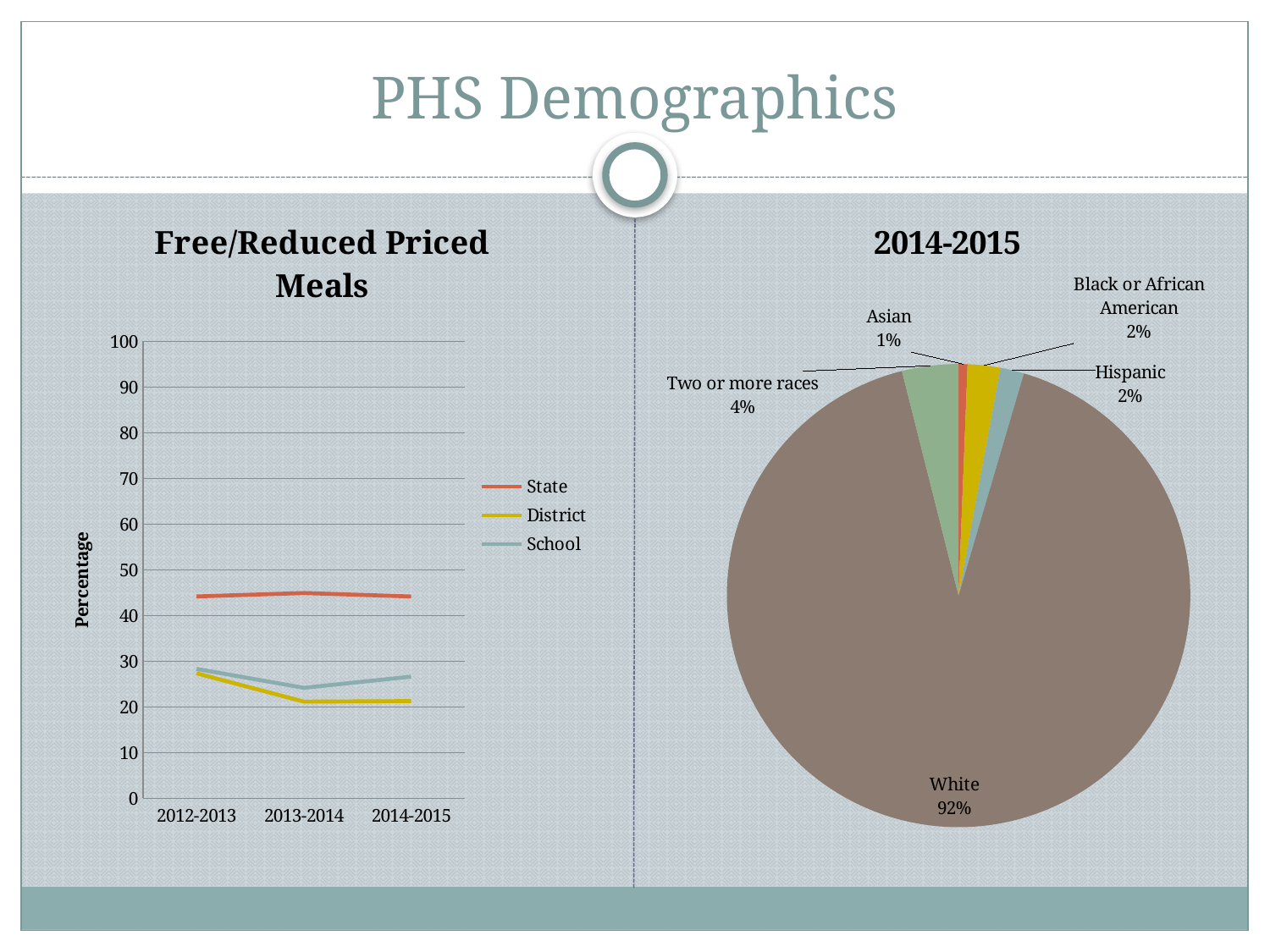
In the 'Free/Reduced Priced Meals' chart, is the District value for 2013-2014 greater or less than 30? less In the '2014-2015' pie chart, what share is Two or more races? 4% In the '2014-2015' pie chart, which category has the smallest share? Asian In the 'Free/Reduced Priced Meals' chart, how many school years are shown on the x axis? 3 In the 'Free/Reduced Priced Meals' chart, is the State value for 2012-2013 greater or less than 40? greater In the '2014-2015' pie chart, what share is White? 92% In the 'Free/Reduced Priced Meals' chart, what kind of chart is shown? line chart In the 'Free/Reduced Priced Meals' chart, which is larger in 2014-2015, School or District? School In the 'Free/Reduced Priced Meals' chart, what is the label on the y axis? Percentage In the 'Free/Reduced Priced Meals' chart, which series has the highest values across all years? State In the '2014-2015' pie chart, how many categories are shown? 5 In the 'Free/Reduced Priced Meals' chart, how many series does the legend list? 3